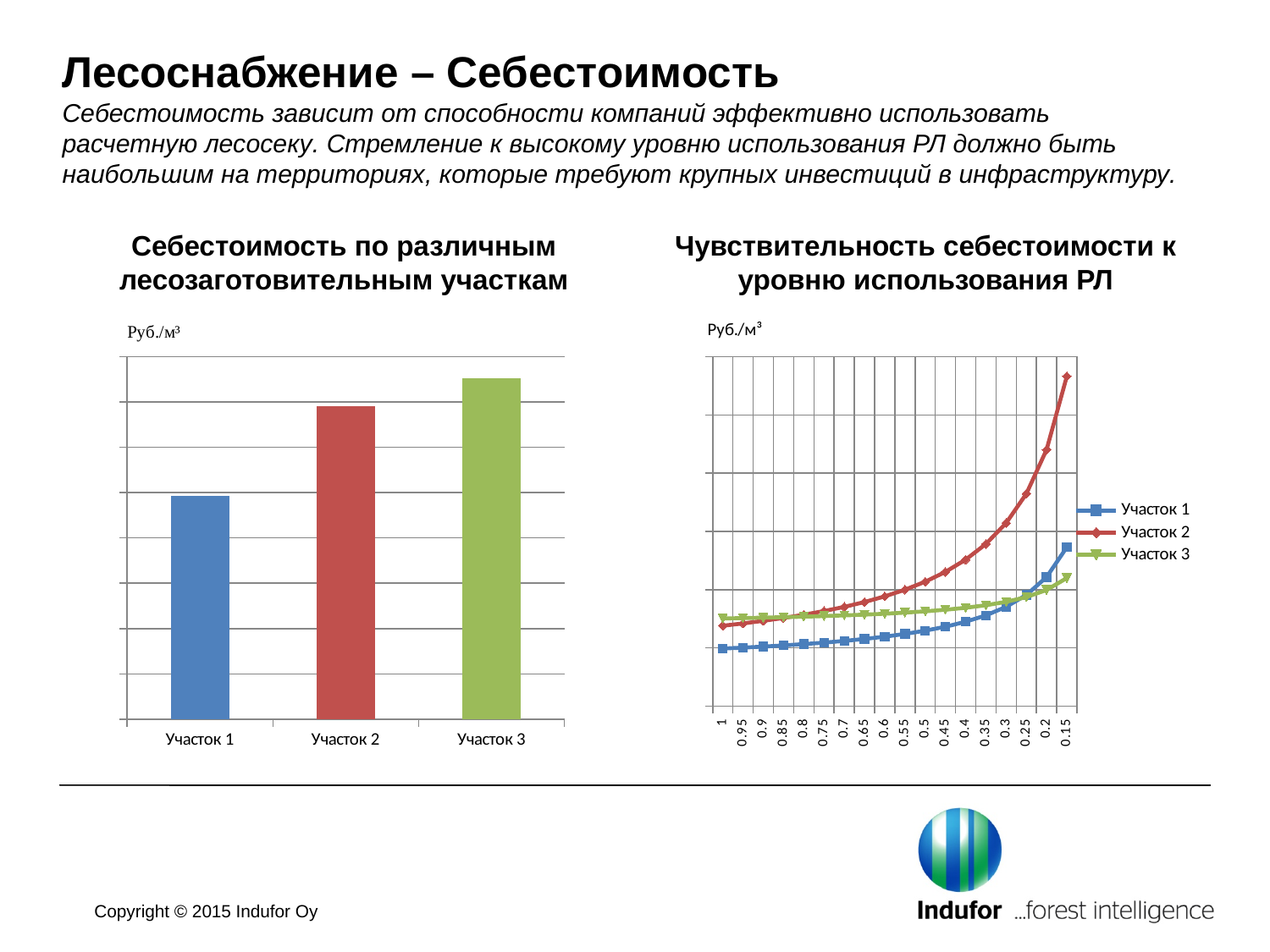
What kind of chart is the right chart 'Чувствительность себестоимости к уровню использования РЛ'? Line chart What unit is shown on the vertical axis of the left chart 'Себестоимость по различным лесозаготовительным участкам'? Руб./м³ In the right chart 'Чувствительность себестоимости к уровню использования РЛ', what are the first and last labels on the x axis? 1 and 0.15 In the left chart 'Себестоимость по различным лесозаготовительным участкам', which category has the highest bar? Участок 3 In the left chart 'Себестоимость по различным лесозаготовительным участкам', which is larger, the bar for Участок 2 or the bar for Участок 3? Участок 3 In the left chart 'Себестоимость по различным лесозаготовительным участкам', which category has the lowest bar? Участок 1 In the right chart 'Чувствительность себестоимости к уровню использования РЛ', do the values of Участок 2 rise or fall moving from left to right along the x axis? Rise What kind of chart is the left chart 'Себестоимость по различным лесозаготовительным участкам'? Bar chart In the left chart 'Себестоимость по различным лесозаготовительным участкам', how many categories are shown? 3 In the right chart 'Чувствительность себестоимости к уровню использования РЛ', which series reaches the highest value at the right end of the x axis (0.15)? Участок 2 In the right chart 'Чувствительность себестоимости к уровню использования РЛ', which series has the lowest value at the left end of the x axis (1)? Участок 1 How many series does the legend of the right chart 'Чувствительность себестоимости к уровню использования РЛ' list? 3